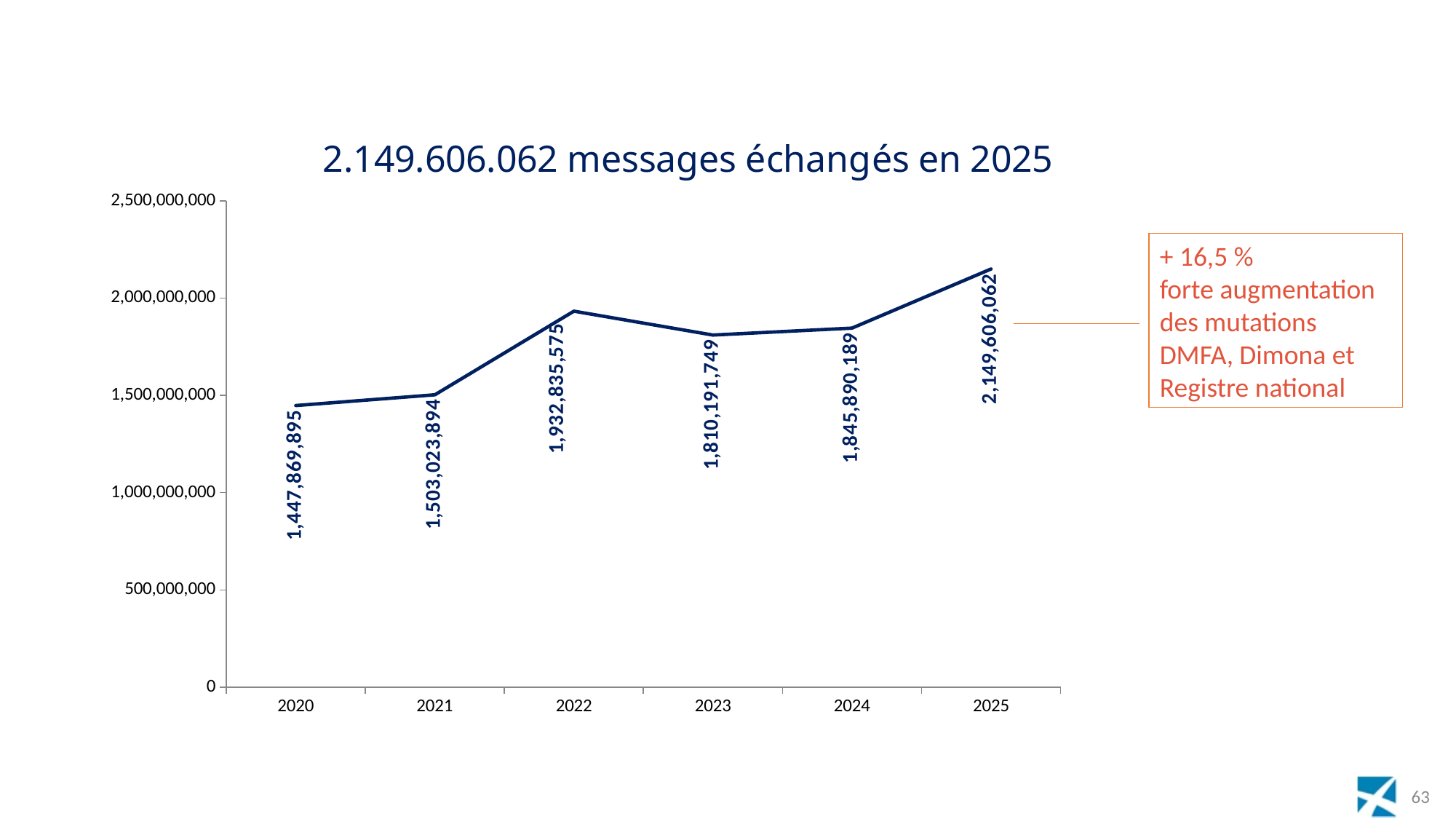
What is the difference between the values for 2022 and 2021? 429,811,681 What is the difference between the values for 2025 and 2024? 303,715,873 Which is larger, the value for 2022 or the value for 2023? 2022 What is the value for 2025? 2,149,606,062 Which year has the lowest value? 2020 What is the value for 2023? 1,810,191,749 What is the value for 2020? 1,447,869,895 How many years are plotted on the x axis? 6 Which year has the highest value? 2025 What is the title of the chart? 2.149.606.062 messages échangés en 2025 What is the value for 2022? 1,932,835,575 What type of chart is shown on the slide? line chart